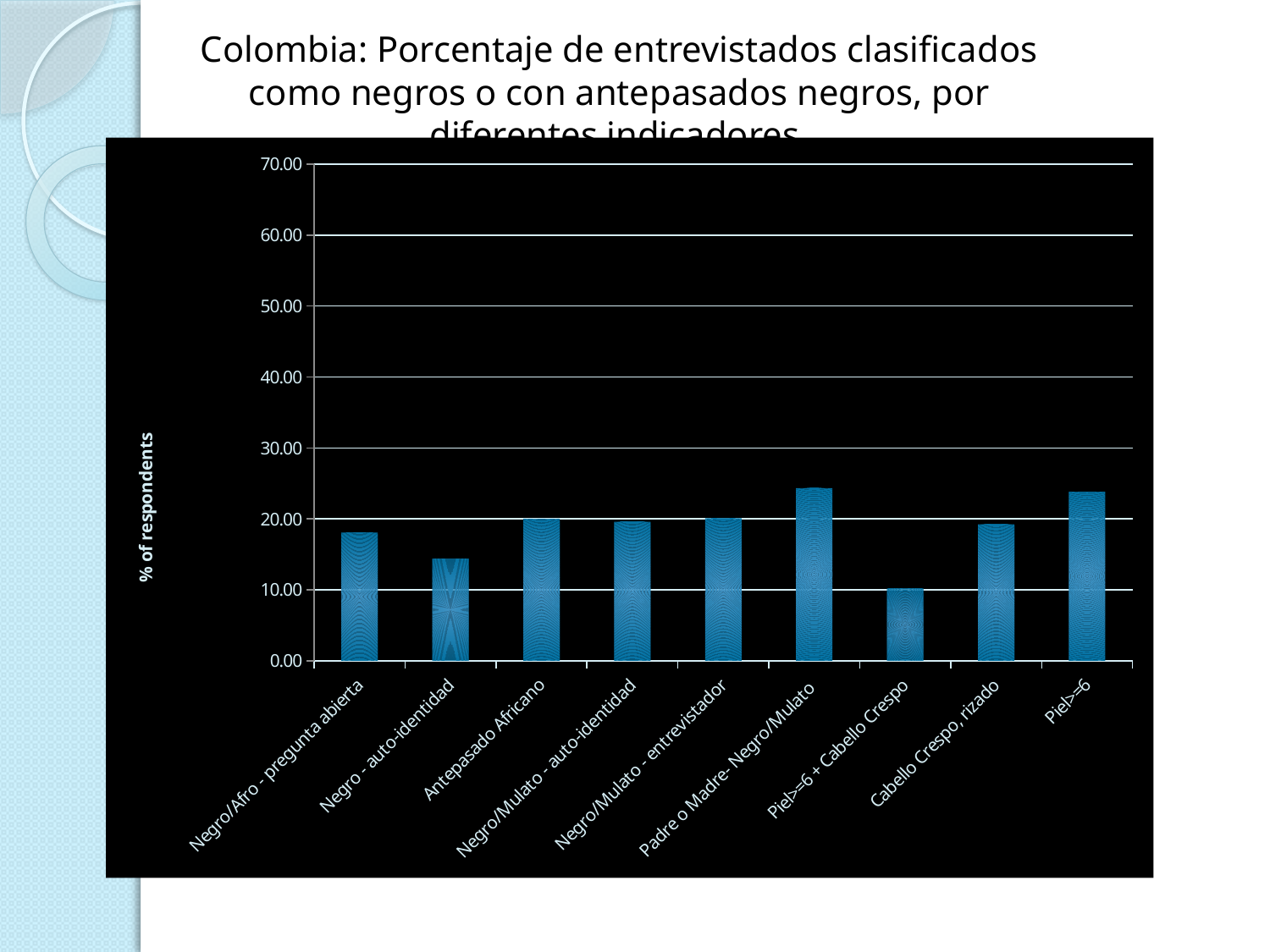
Is the value for Piel>=6 greater or less than 30? less Which is larger, the value for Negro/Afro - pregunta abierta or the value for Negro - auto-identidad? Negro/Afro - pregunta abierta What is the title of the vertical axis? % of respondents Is the value for Padre o Madre- Negro/Mulato greater or less than 20? greater What kind of chart is shown on the slide? bar chart Which category has the lowest value? Piel>=6 + Cabello Crespo How many categories are plotted on the x axis? 9 Which is larger, the value for Piel>=6 or the value for Cabello Crespo, rizado? Piel>=6 Which is larger, the value for Padre o Madre- Negro/Mulato or the value for Piel>=6 + Cabello Crespo? Padre o Madre- Negro/Mulato What is the highest value shown on the vertical axis? 70.00 Is the value for Negro - auto-identidad greater or less than 20? less